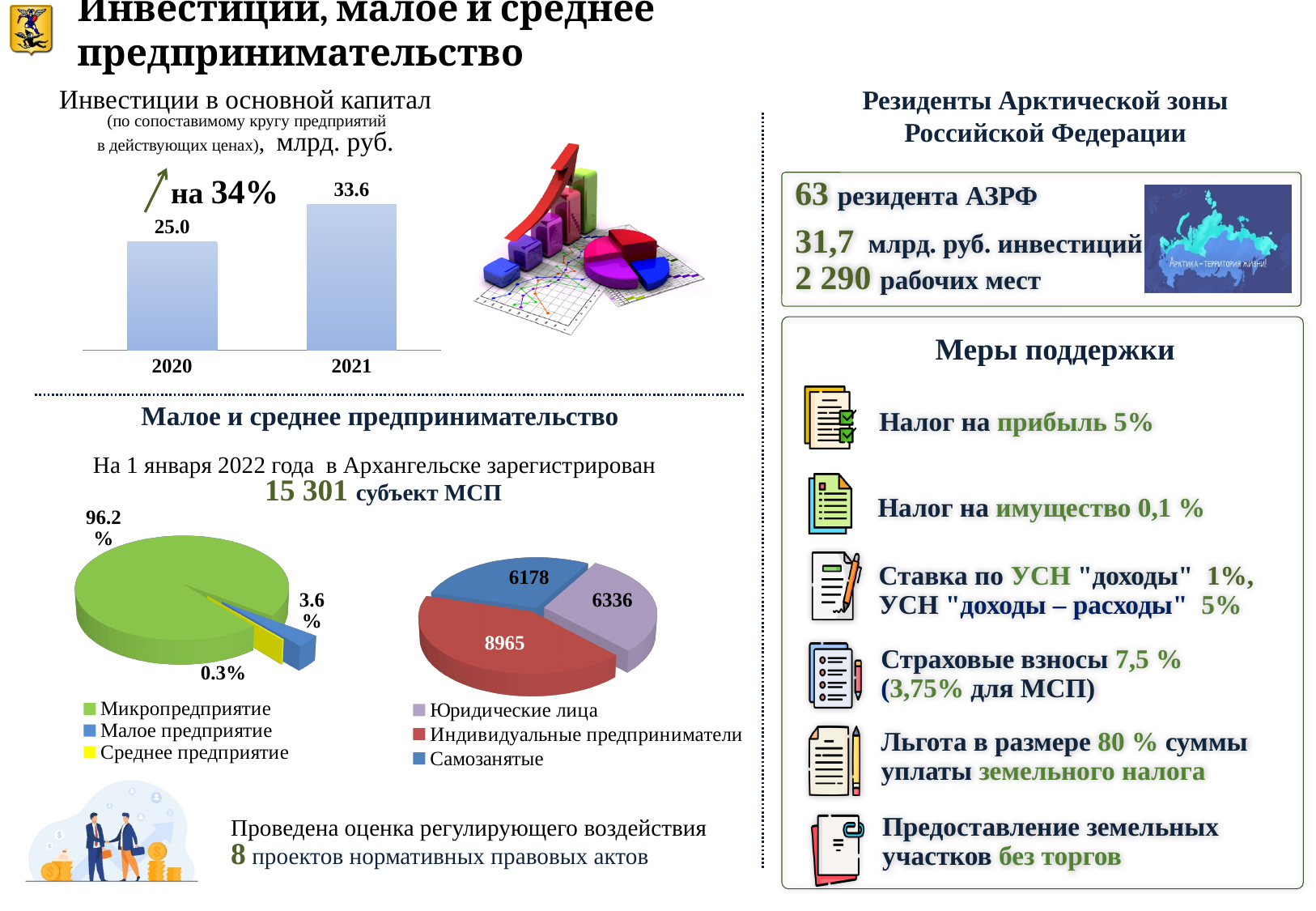
In the right pie chart under 'Малое и среднее предпринимательство', which category has the largest value? Индивидуальные предприниматели In the right pie chart under 'Малое и среднее предпринимательство', what is the difference between 'Юридические лица' and 'Самозанятые'? 158 In the left pie chart under 'Малое и среднее предпринимательство', what share is 'Среднее предприятие'? 0.3% In the bar chart 'Инвестиции в основной капитал', what is the value for 2020? 25.0 In the left pie chart under 'Малое и среднее предпринимательство', what share is 'Микропредприятие'? 96.2% In the bar chart 'Инвестиции в основной капитал', do the values rise or fall from 2020 to 2021? rise In the bar chart 'Инвестиции в основной капитал', by how much did the value change from 2020 to 2021? 8.6 In the left pie chart under 'Малое и среднее предпринимательство', which category has the smallest share? Среднее предприятие How many categories are shown in the bar chart 'Инвестиции в основной капитал'? 2 In the right pie chart under 'Малое и среднее предпринимательство', what is the value for 'Индивидуальные предприниматели'? 8965 In the bar chart 'Инвестиции в основной капитал', what is the value for 2021? 33.6 What kind of chart is used for 'Инвестиции в основной капитал'? bar chart